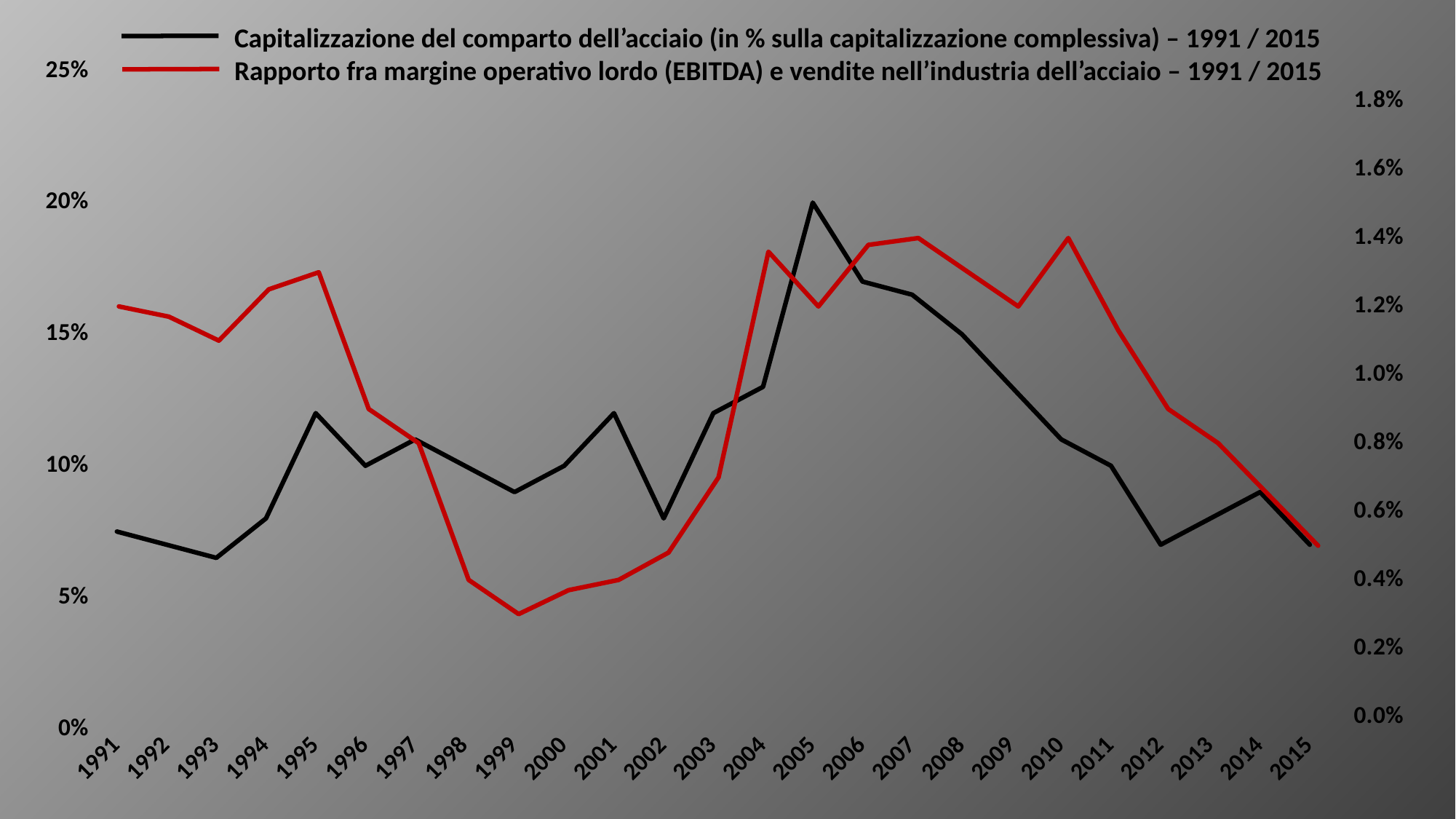
How many series does the legend list? 2 What colour is the line for the 'Rapporto fra margine operativo lordo (EBITDA) e vendite' series? red In which year does the 'Rapporto fra margine operativo lordo (EBITDA) e vendite' series reach its lowest value? 1999 In which year does the 'Capitalizzazione del comparto dell'acciaio' series reach its highest value? 2005 What kind of chart is shown on the slide? line chart Does the 'Capitalizzazione del comparto dell'acciaio' series rise or fall between 2005 and 2012? fall Is the value of the 'Capitalizzazione del comparto dell'acciaio' series in 1993 greater or less than 10%? less Which year has the larger value for the 'Capitalizzazione del comparto dell'acciaio' series, 2002 or 2005? 2005 Is the value of the 'Rapporto fra margine operativo lordo (EBITDA) e vendite' series in 1995 greater or less than 1.2%? greater Is the value of the 'Rapporto fra margine operativo lordo (EBITDA) e vendite' series in 1999 greater or less than 0.4%? less How many years are plotted along the x axis? 25